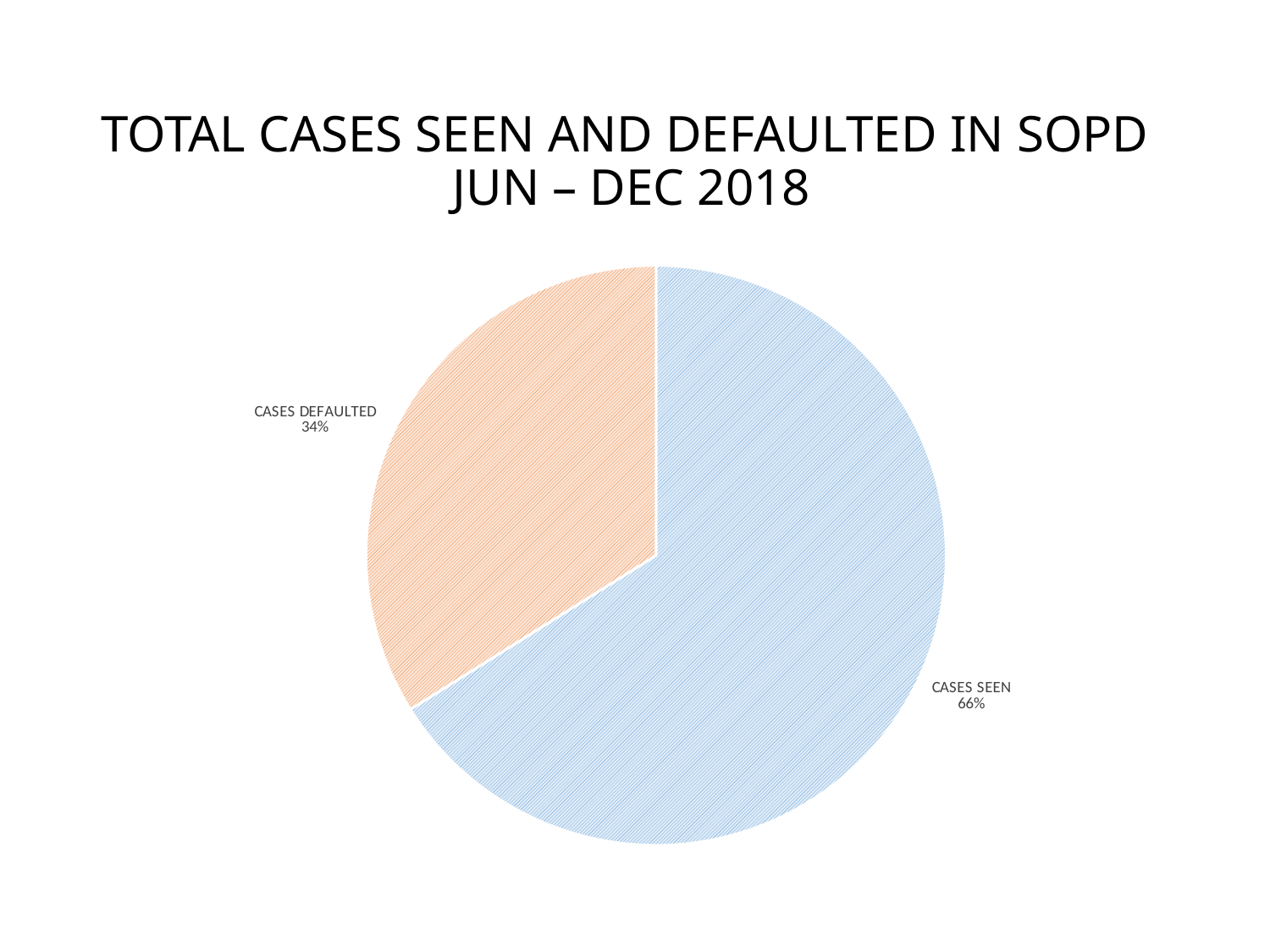
What is the title of the slide? TOTAL CASES SEEN AND DEFAULTED IN SOPD JUN – DEC 2018 Which is larger, CASES SEEN or CASES DEFAULTED? CASES SEEN How many slices does the pie chart have? 2 What share of the pie is CASES SEEN? 66% What share of the pie is CASES DEFAULTED? 34% Which slice is the smallest? CASES DEFAULTED What kind of chart is shown on the slide? pie chart What colour is the CASES DEFAULTED slice? orange What is the difference in percentage points between CASES SEEN and CASES DEFAULTED? 32 Which slice is the largest? CASES SEEN